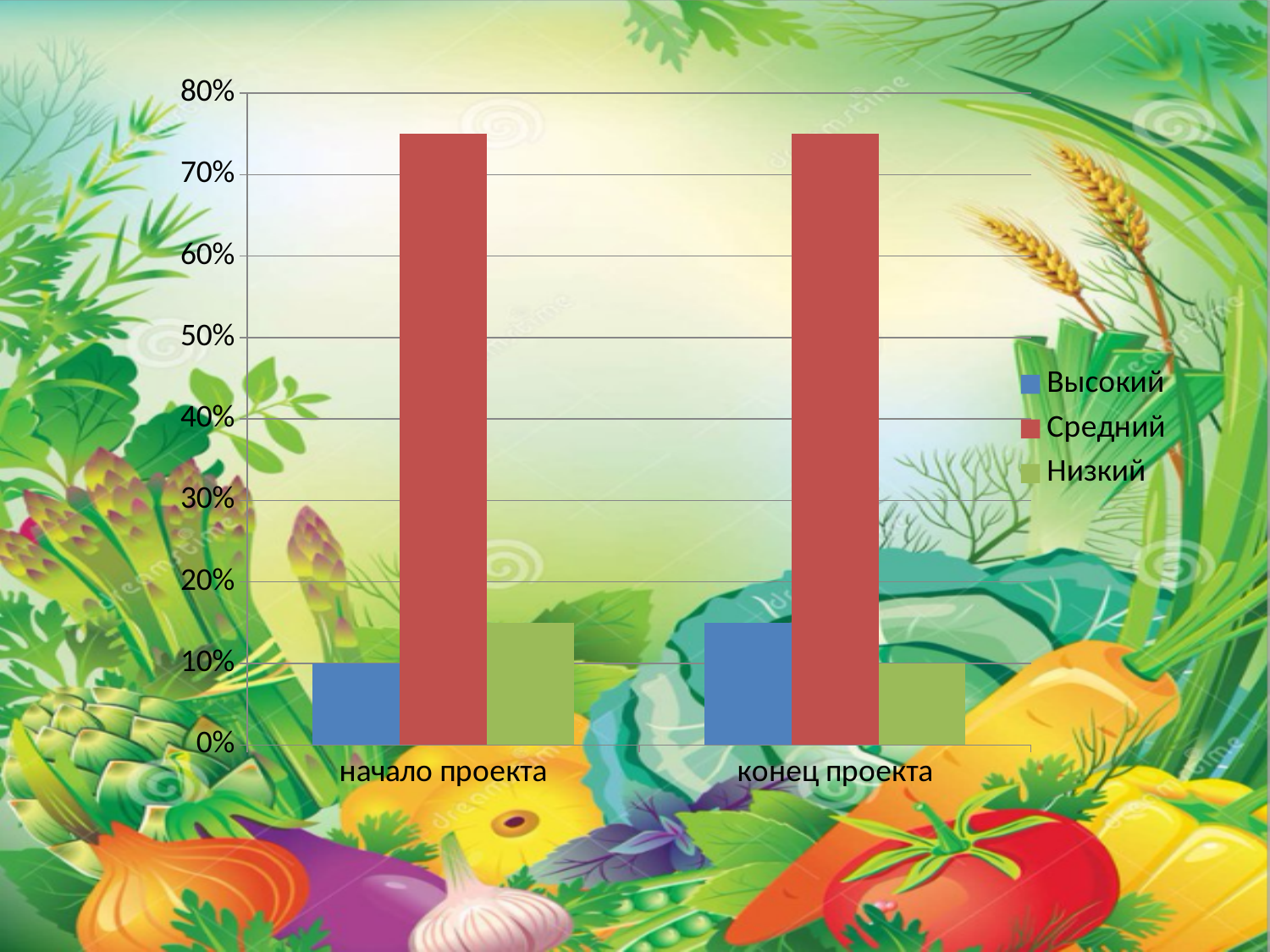
Which series is highest for "начало проекта"? Средний What is the value of "Низкий" for "конец проекта"? 10% Does the value of "Низкий" rise or fall from "начало проекта" to "конец проекта"? fall What is the value of "Высокий" for "начало проекта"? 10% Which is larger: "Высокий" for "начало проекта" or "Высокий" for "конец проекта"? конец проекта Which series is lowest for "конец проекта"? Низкий Is the value of "Средний" for "начало проекта" greater or less than 70%? greater What colour are the bars for the "Средний" series? red What kind of chart is shown on the slide? bar chart How many series does the legend list? 3 Is the value of "Низкий" for "начало проекта" greater or less than 20%? less How many categories are shown on the x axis? 2